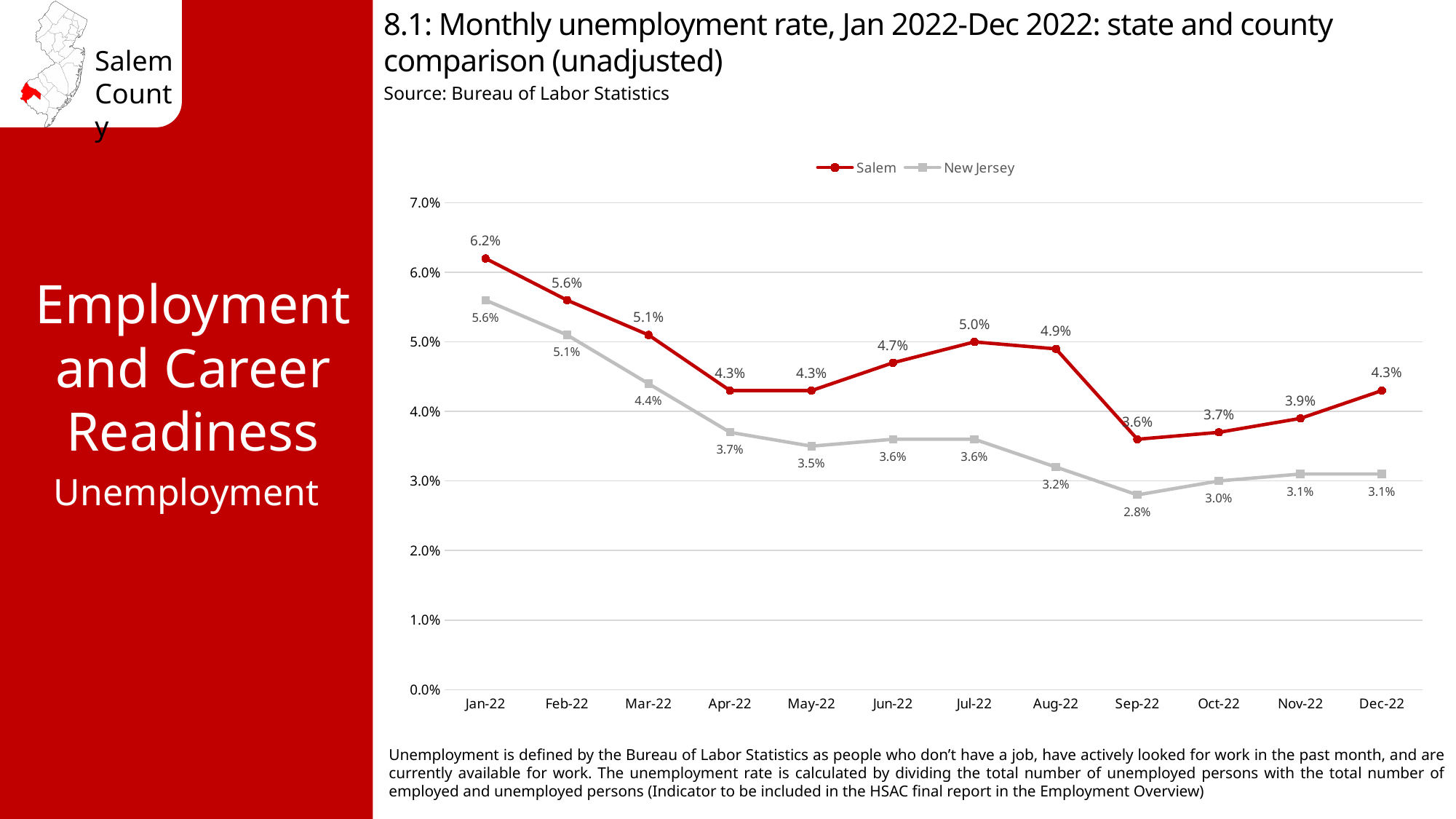
In which month was the Salem unemployment rate lowest? Sep-22 What kind of chart is shown on the slide? Line chart What is the difference between the Salem and New Jersey unemployment rates in Aug-22? 1.7% What was the Salem unemployment rate in Jul-22? 5.0% What was the Salem unemployment rate in Jan-22? 6.2% Is the New Jersey unemployment rate in Mar-22 greater or less than 4.0%? greater How many months are shown on the x axis? 12 What was the New Jersey unemployment rate in Sep-22? 2.8% In which month was the New Jersey unemployment rate highest? Jan-22 What is the source cited for the chart? Bureau of Labor Statistics How many series does the legend list? 2 Which series had the higher unemployment rate in Dec-22, Salem or New Jersey? Salem